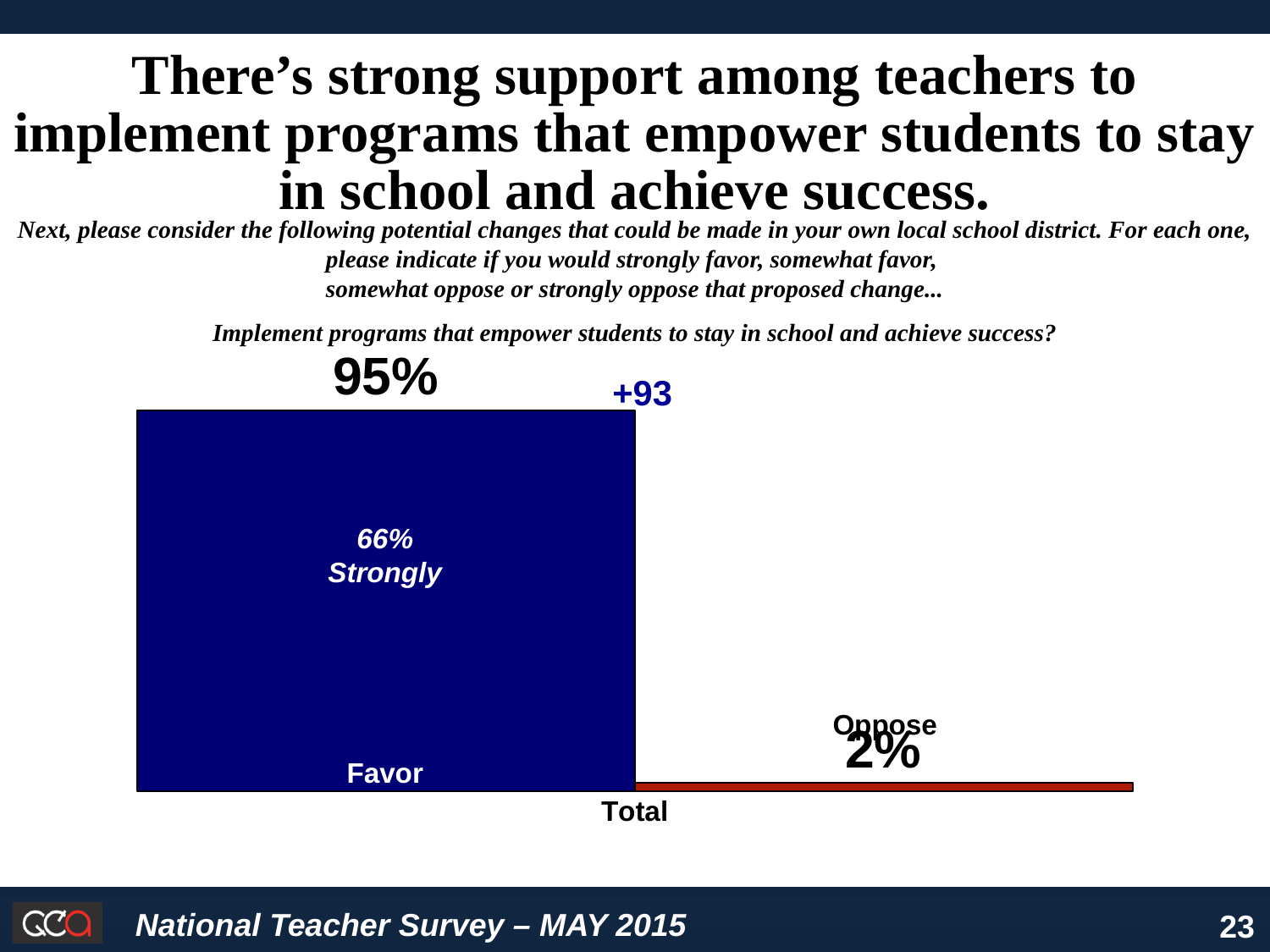
What percentage of teachers oppose implementing programs that empower students to stay in school and achieve success? 2% What percentage of teachers favor implementing programs that empower students to stay in school and achieve success? 95% What is the net figure shown above the Favor bar? +93 What is the difference between the Favor and Oppose percentages? 93 percentage points What kind of chart is shown on the slide? Bar chart How many bars are plotted on the chart? 2 What colour is the Favor bar? Dark blue Which response is higher, Favor or Oppose? Favor What percentage of teachers strongly favor the proposed change, as labeled inside the Favor bar? 66% Which response has the lowest value on the chart? Oppose What is the category label shown beneath the bars on the x axis? Total